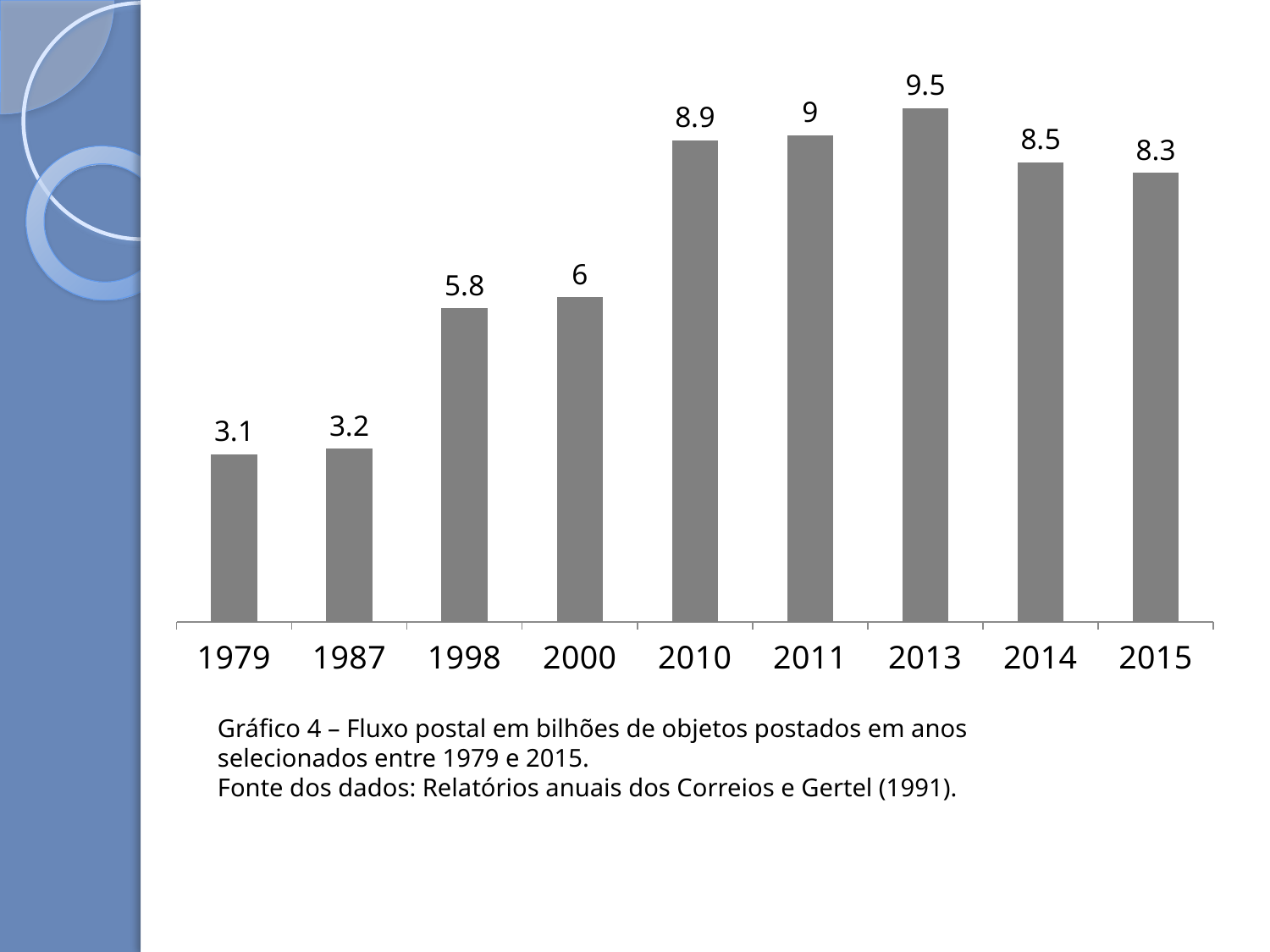
Which year has the lowest value? 1979 Do the values rise or fall from 2013 to 2015? fall What is the value for 1979? 3.1 How many years are shown on the x axis? 9 What is the value for 2015? 8.3 What kind of chart is shown on the slide? bar chart What is the difference between the values for 2013 and 1979? 6.4 What is the value for 2013? 9.5 Which is larger, the value for 2011 or the value for 2014? 2011 What is the value for 2000? 6 Which year has the highest value? 2013 What is the difference between the values for 2010 and 1998? 3.1